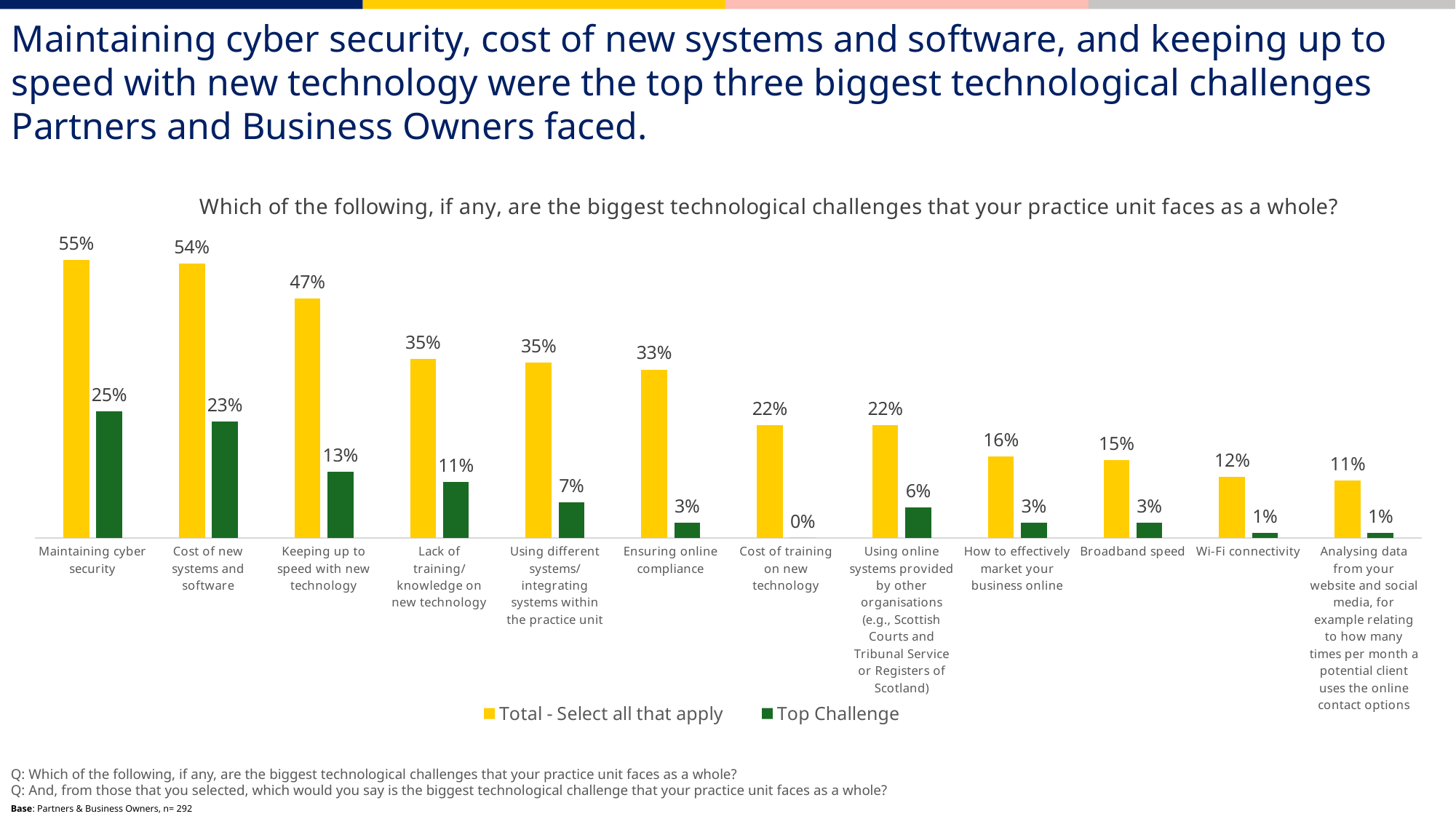
How many series does the legend list? 2 What is the 'Top Challenge' value for Cost of training on new technology? 0% What kind of chart is shown on the slide? Bar chart How many categories are shown on the x axis of the chart? 12 What is the difference between the 'Total - Select all that apply' and 'Top Challenge' values for Keeping up to speed with new technology? 34% Which is larger: the 'Top Challenge' value for Maintaining cyber security or for Lack of training/knowledge on new technology? Maintaining cyber security What is the 'Top Challenge' value for Cost of new systems and software? 23% Which category has the highest 'Total - Select all that apply' value? Maintaining cyber security Which category has the lowest 'Total - Select all that apply' value? Analysing data from your website and social media, for example relating to how many times per month a potential client uses the online contact options Do the 'Total - Select all that apply' values generally rise or fall from left to right along the x axis? Fall Which colour represents the 'Top Challenge' series in the chart? Green What is the 'Total - Select all that apply' value for Maintaining cyber security? 55%